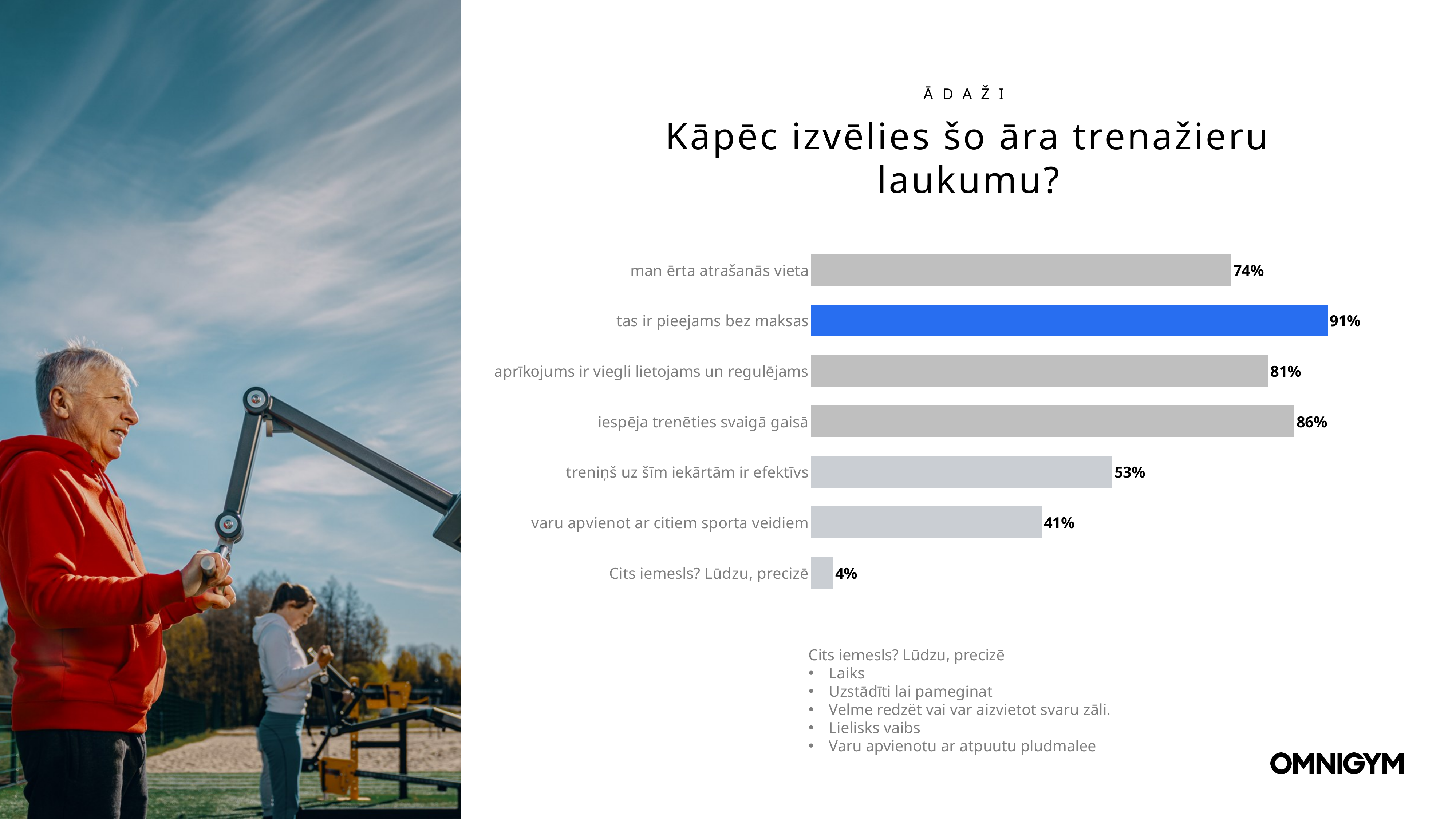
Which category has the lowest value? Cits iemesls? Lūdzu, precizē What is the title of the chart? Kāpēc izvēlies šo āra trenažieru laukumu? What is the difference between the values for "iespēja trenēties svaigā gaisā" and "aprīkojums ir viegli lietojams un regulējams"? 5% Which category has the highest value? tas ir pieejams bez maksas What is the value for "man ērta atrašanās vieta"? 74% Which is larger: the value for "varu apvienot ar citiem sporta veidiem" or the value for "treniņš uz šīm iekārtām ir efektīvs"? treniņš uz šīm iekārtām ir efektīvs Which bar is highlighted in blue? tas ir pieejams bez maksas What kind of chart is shown on the slide? bar chart What is the value for "tas ir pieejams bez maksas"? 91% What is the value for "treniņš uz šīm iekārtām ir efektīvs"? 53% How many categories are shown in the chart? 7 What is the value for "Cits iemesls? Lūdzu, precizē"? 4%